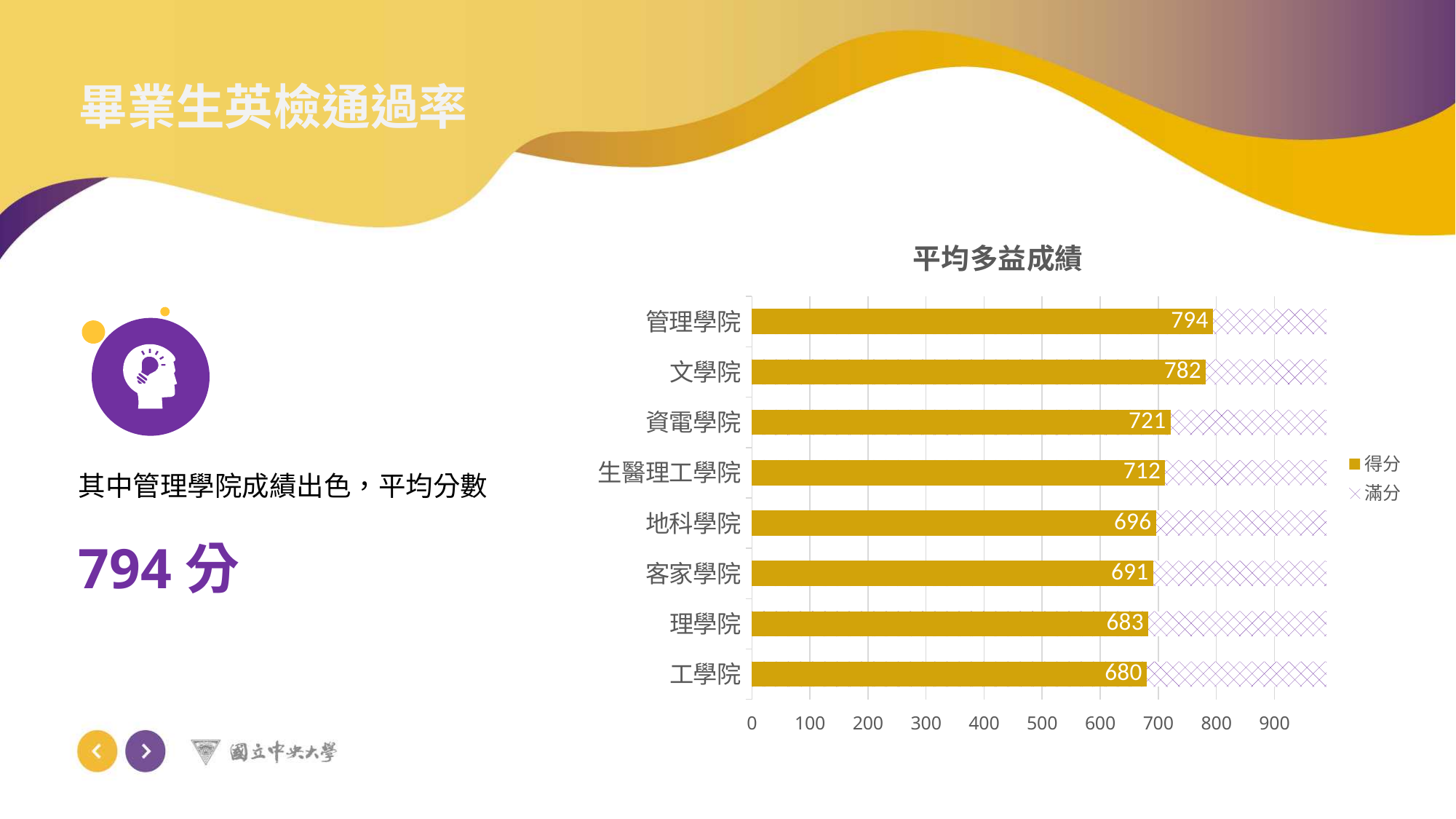
What is the 得分 value for 生醫理工學院? 712 Which has a higher 得分, 客家學院 or 理學院? 客家學院 How many colleges are shown in the chart? 8 What is the 得分 value for 管理學院 in the 平均多益成績 chart? 794 What is the difference between the 得分 of 資電學院 and 工學院? 41 What is the 得分 value for 地科學院? 696 How many series does the legend list? 2 What is the difference between the 得分 of 管理學院 and 文學院? 12 What type of chart is shown on the slide? Bar chart Which college has the lowest 得分 in the chart? 工學院 Which college has the highest 得分 in the chart? 管理學院 Is the 得分 value for 文學院 greater or less than 700? greater